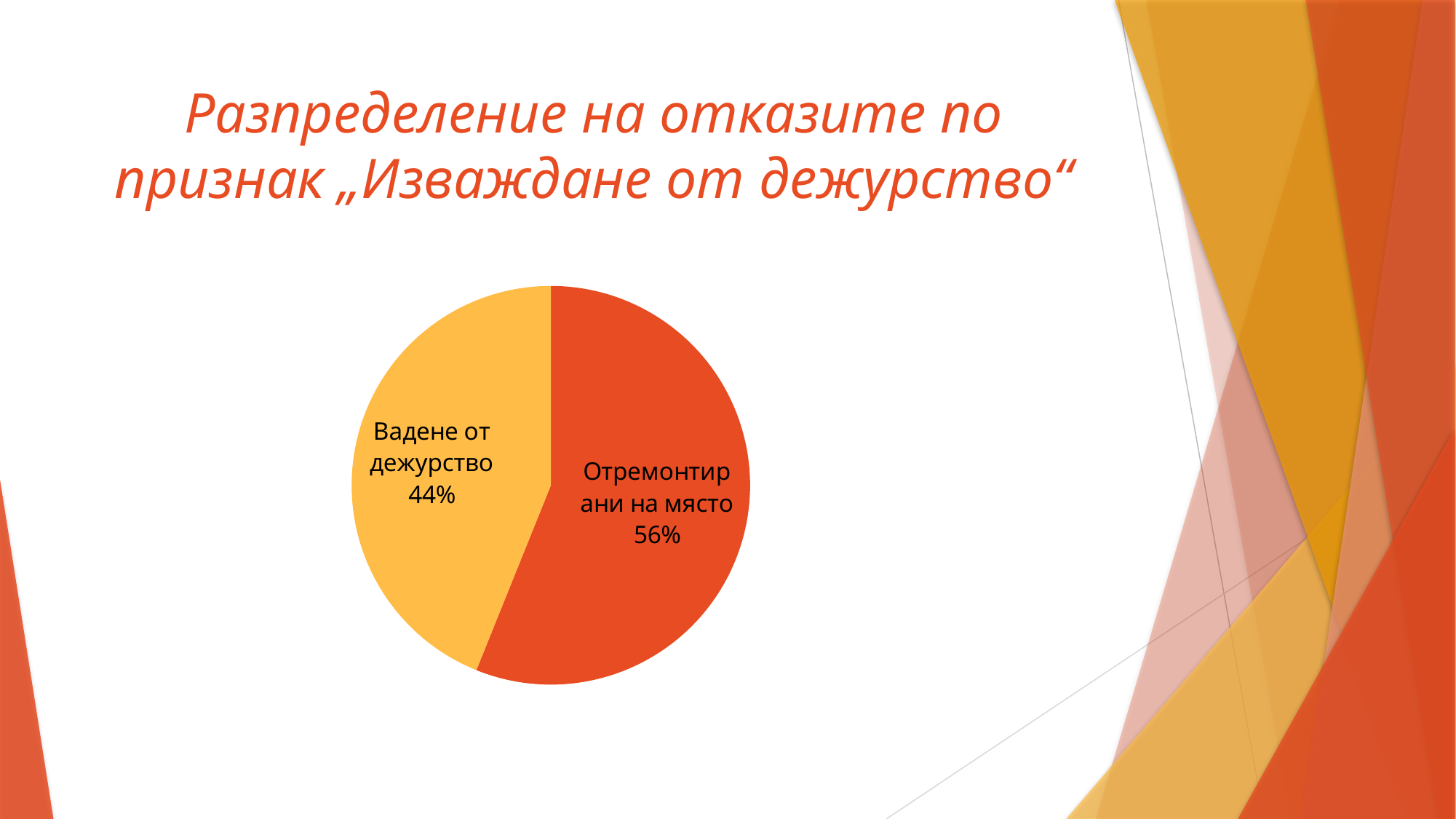
Which is larger: "Отремонтирани на място" or "Вадене от дежурство"? Отремонтирани на място What is the title of the slide containing the pie chart? Разпределение на отказите по признак „Изваждане от дежурство“ What share of the pie does "Вадене от дежурство" have? 44% How many slices does the pie chart have? 2 What colour is the "Вадене от дежурство" slice? Yellow-orange What kind of chart is shown on the slide? Pie chart What share of the pie does "Отремонтирани на място" have? 56% Which slice is the largest? Отремонтирани на място What is the difference in percentage points between "Отремонтирани на място" and "Вадене от дежурство"? 12 Which slice is the smallest? Вадене от дежурство Is the share for "Вадене от дежурство" greater or less than 50%? less